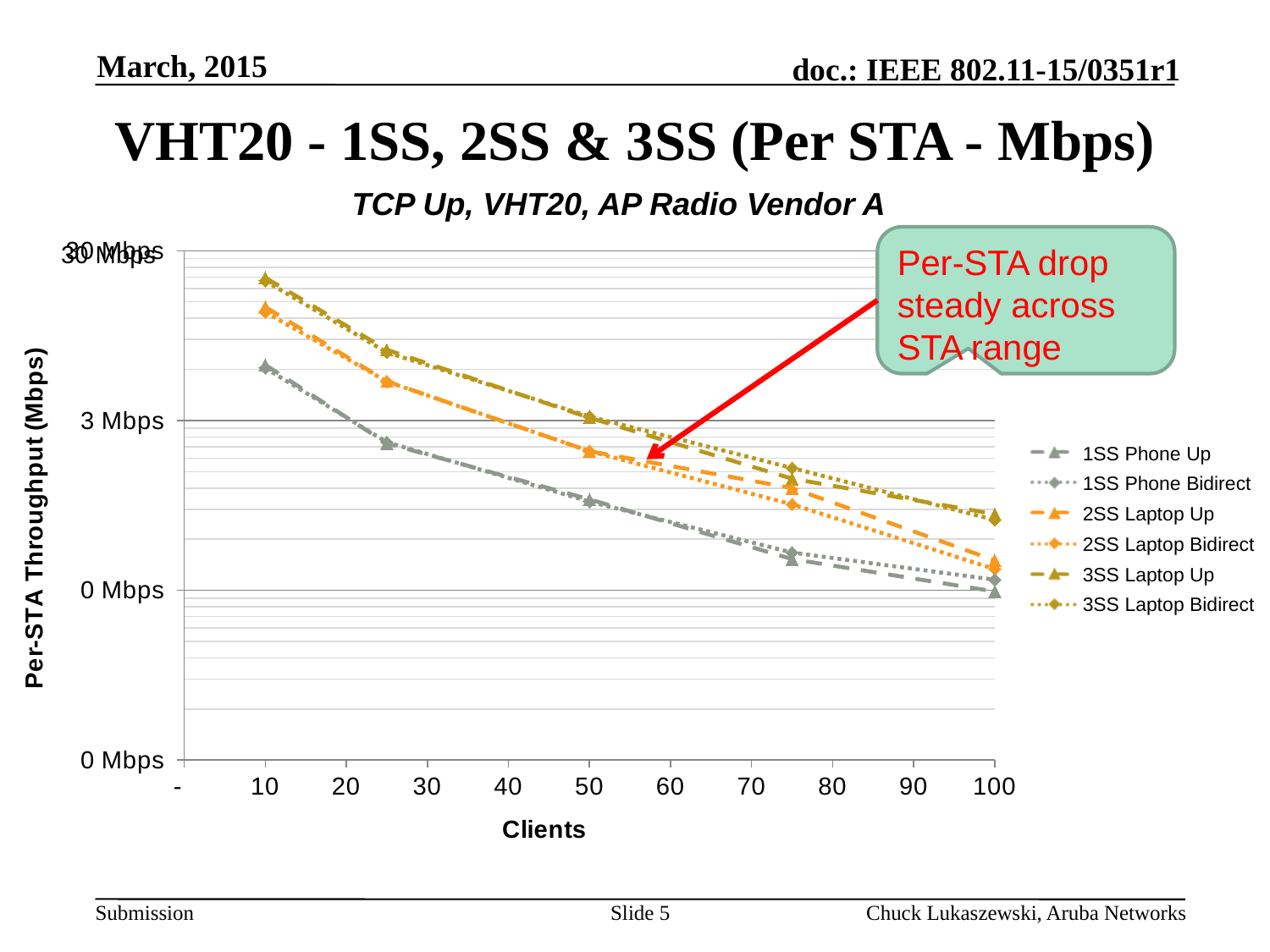
What kind of chart is shown on the slide? line chart Do the per-STA throughput values rise or fall as the number of clients increases? fall What is the subtitle shown above the chart? TCP Up, VHT20, AP Radio Vendor A How many series does the legend list? 6 At 25 clients, which is larger: 3SS Laptop Up or 1SS Phone Up? 3SS Laptop Up What is the label of the x axis? Clients Is the value for 3SS Laptop Up at 100 clients greater or less than 3 Mbps? less How many client counts are plotted for each series? 5 At 75 clients, which is larger: 2SS Laptop Up or 1SS Phone Up? 2SS Laptop Up Is the value for 1SS Phone Up at 50 clients greater or less than 3 Mbps? less Is the value for 1SS Phone Up at 10 clients greater or less than 3 Mbps? greater